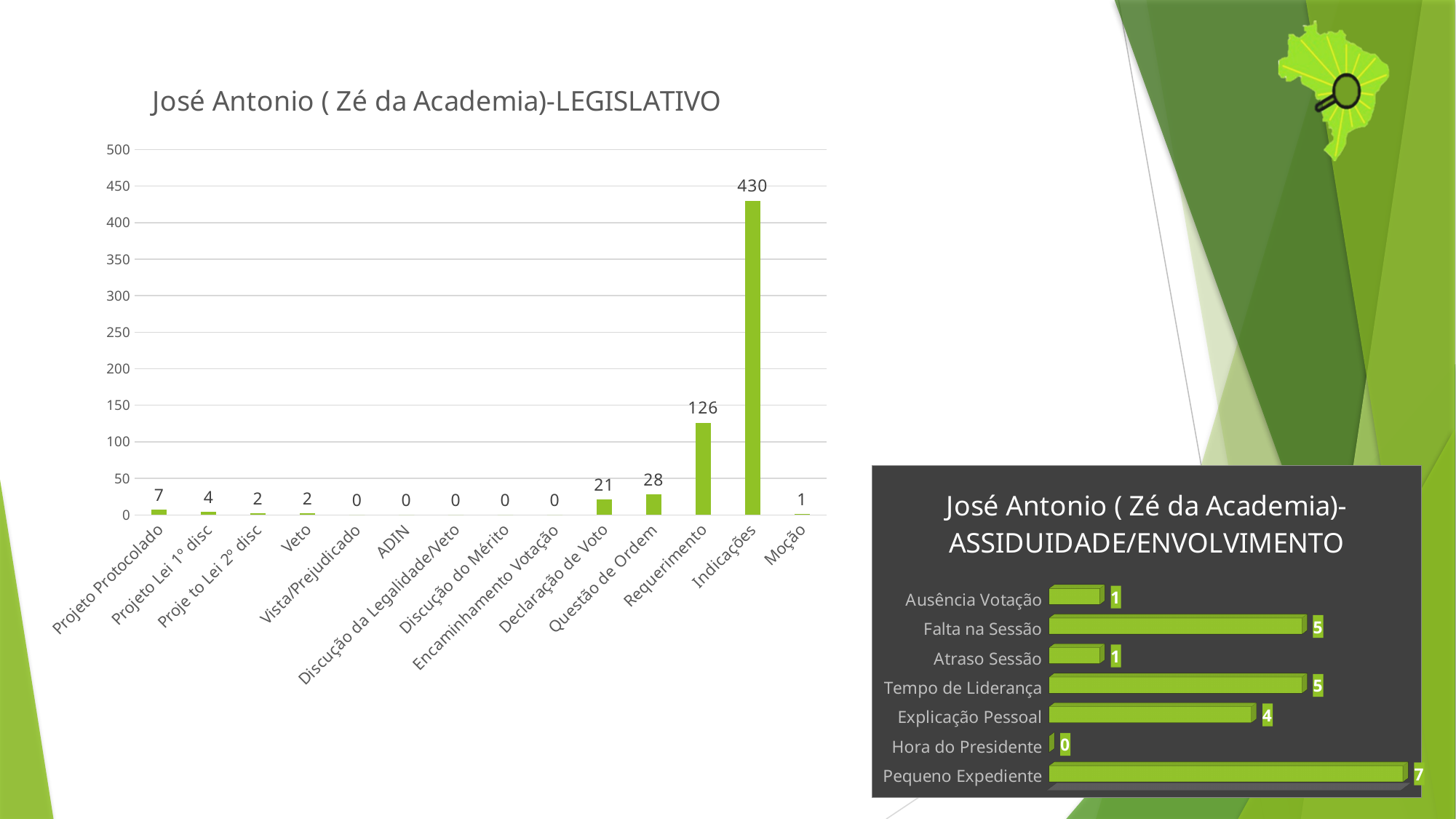
In the LEGISLATIVO chart, what is the difference between Indicações and Requerimento? 304 In the LEGISLATIVO chart, what is the value for Indicações? 430 In the LEGISLATIVO chart, how many categories are shown on the x axis? 14 In the ASSIDUIDADE/ENVOLVIMENTO chart, what is the value for Pequeno Expediente? 7 In the LEGISLATIVO chart, which category has the highest value? Indicações In the LEGISLATIVO chart, what is the value for Requerimento? 126 What kind of chart is the LEGISLATIVO chart? Bar chart In the LEGISLATIVO chart, which is larger, Declaração de Voto or Questão de Ordem? Questão de Ordem In the ASSIDUIDADE/ENVOLVIMENTO chart, which category has the lowest value? Hora do Presidente In the LEGISLATIVO chart, what is the value for Questão de Ordem? 28 In the ASSIDUIDADE/ENVOLVIMENTO chart, how many categories are shown? 7 In the ASSIDUIDADE/ENVOLVIMENTO chart, what is the difference between Falta na Sessão and Explicação Pessoal? 1